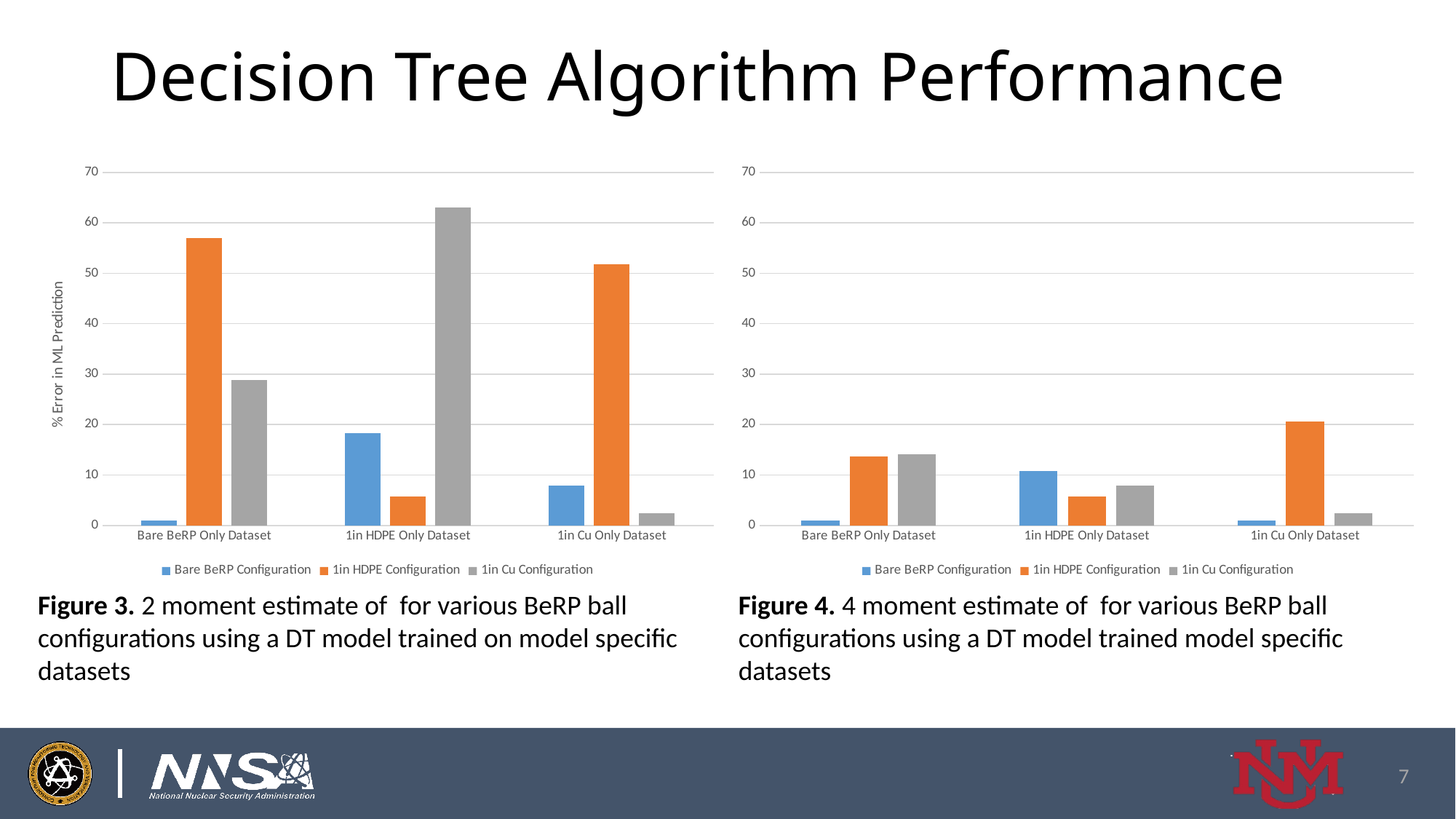
In the right chart (Figure 4), which configuration has the highest value for the 1in HDPE Only Dataset? Bare BeRP Configuration What kind of chart is the left chart (Figure 3)? bar chart In the right chart (Figure 4), is the value for 1in HDPE Configuration on the 1in Cu Only Dataset greater or less than 10? greater In the left chart (Figure 3), for the Bare BeRP Only Dataset, which is larger: 1in HDPE Configuration or 1in Cu Configuration? 1in HDPE Configuration What is the y-axis label of the left chart (Figure 3)? % Error in ML Prediction In the right chart (Figure 4), which configuration has the highest value for the 1in Cu Only Dataset? 1in HDPE Configuration In the left chart (Figure 3), which configuration has the highest value for the 1in HDPE Only Dataset? 1in Cu Configuration How many series does the legend of the right chart (Figure 4) list? 3 In the left chart (Figure 3), is the value for 1in HDPE Configuration on the Bare BeRP Only Dataset greater or less than 50? greater How many dataset categories are shown on the x axis of the left chart (Figure 3)? 3 In the left chart (Figure 3), is the value for 1in Cu Configuration on the Bare BeRP Only Dataset greater or less than 40? less In the left chart (Figure 3), which configuration has the lowest value for the 1in Cu Only Dataset? 1in Cu Configuration